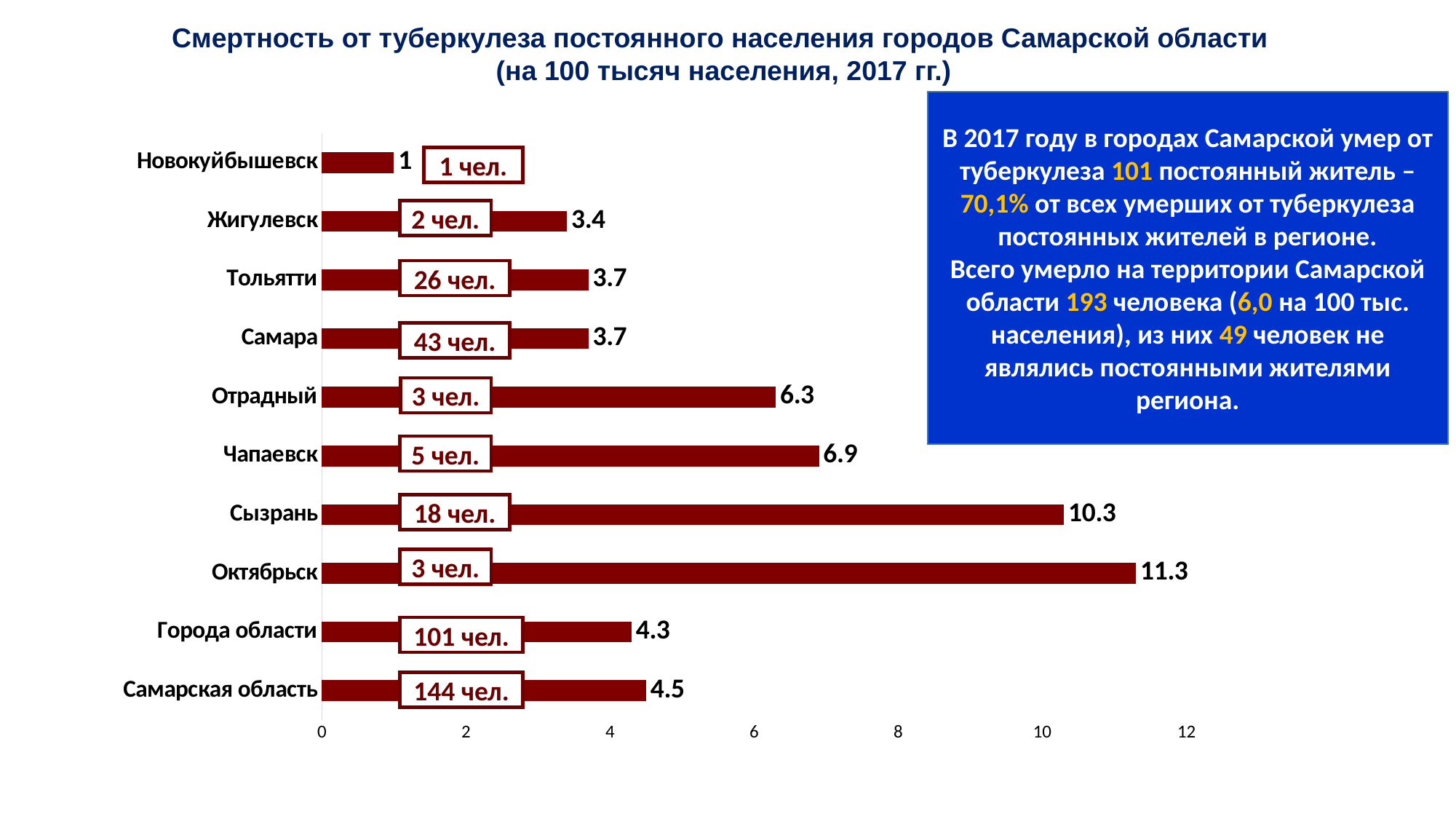
Which has a higher value, Чапаевск or Отрадный? Чапаевск How many categories are shown on the chart? 10 What is the tuberculosis mortality rate per 100 thousand population for Сызрань? 10.3 How many deaths (чел.) are labelled on the bar for Тольятти? 26 чел. Is the value for Сызрань greater or less than 10? greater Which city has the highest mortality rate on the chart? Октябрьск What is the value shown for Самарская область? 4.5 What is the difference between the values for Октябрьск and Сызрань? 1 What is the value shown for Отрадный? 6.3 What type of chart is shown on the slide? Bar chart Which category has the lowest value on the chart? Новокуйбышевск What is the difference between the values for Самарская область and Города области? 0.2